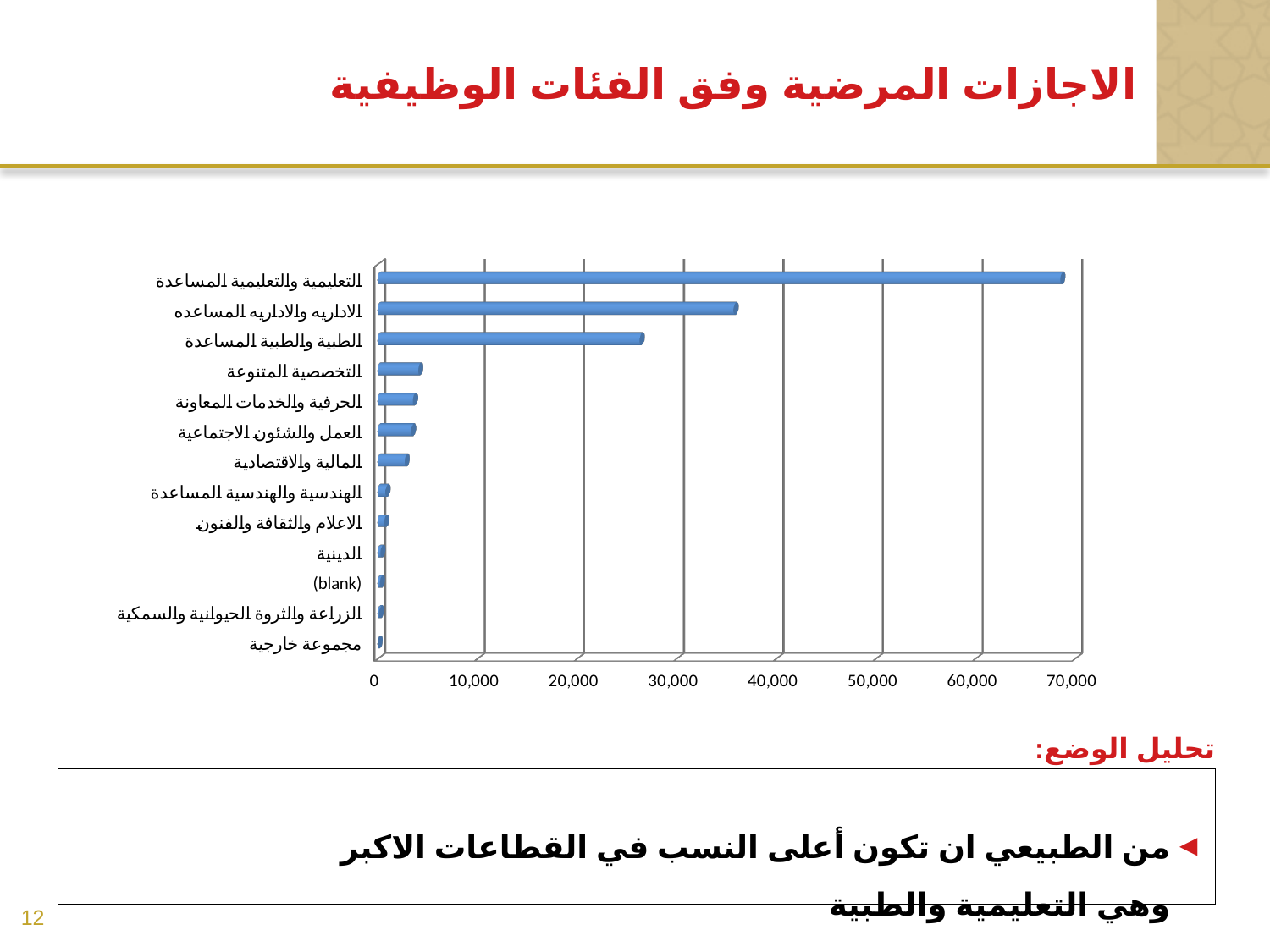
Which is larger, the value for المالية والاقتصادية or the value for التعليمية والتعليمية المساعدة? التعليمية والتعليمية المساعدة Is the value for الطبية والطبية المساعدة greater or less than 20,000? greater Do the bar values increase or decrease going from the top category to the bottom category? decrease How many categories are plotted in the chart? 13 Is the value for التخصصية المتنوعة greater or less than 10,000? less Is the value for التعليمية والتعليمية المساعدة greater or less than 60,000? greater What kind of chart is shown on the slide? bar chart What is the highest value shown on the horizontal axis of the chart? 70,000 What is the title of the slide containing the chart? الاجازات المرضية وفق الفئات الوظيفية Which is larger, the value for الادارية والادارية المساعدة or the value for الطبية والطبية المساعدة? الادارية والادارية المساعدة Which category has the highest value in the chart? التعليمية والتعليمية المساعدة